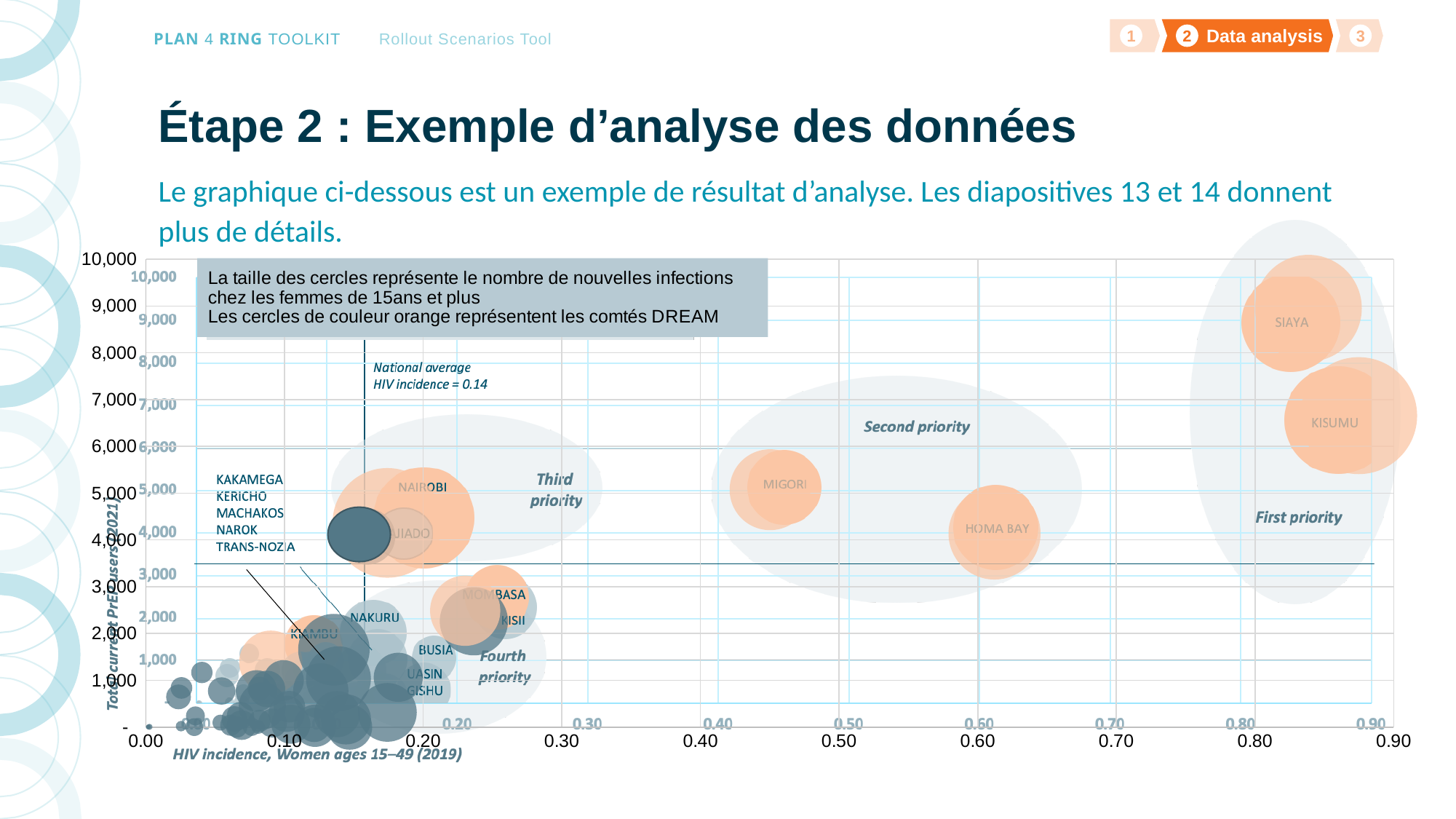
Is the total current PrEP users value for KISUMU greater or less than 6,000? greater Which county has the highest number of total current PrEP users (highest on the y axis)? SIAYA According to the note on the chart, what do the orange circles represent? DREAM counties Is the total current PrEP users value for SIAYA greater or less than 8,000? greater Is the HIV incidence value for HOMA BAY greater or less than 0.50? greater What is the national average HIV incidence shown on the chart? 0.14 What kind of chart is shown on the slide? Bubble chart Which county has a higher HIV incidence, HOMA BAY or MIGORI? HOMA BAY Which county has the highest HIV incidence (furthest right on the x axis)? KISUMU Which county has more total current PrEP users, SIAYA or KISUMU? SIAYA